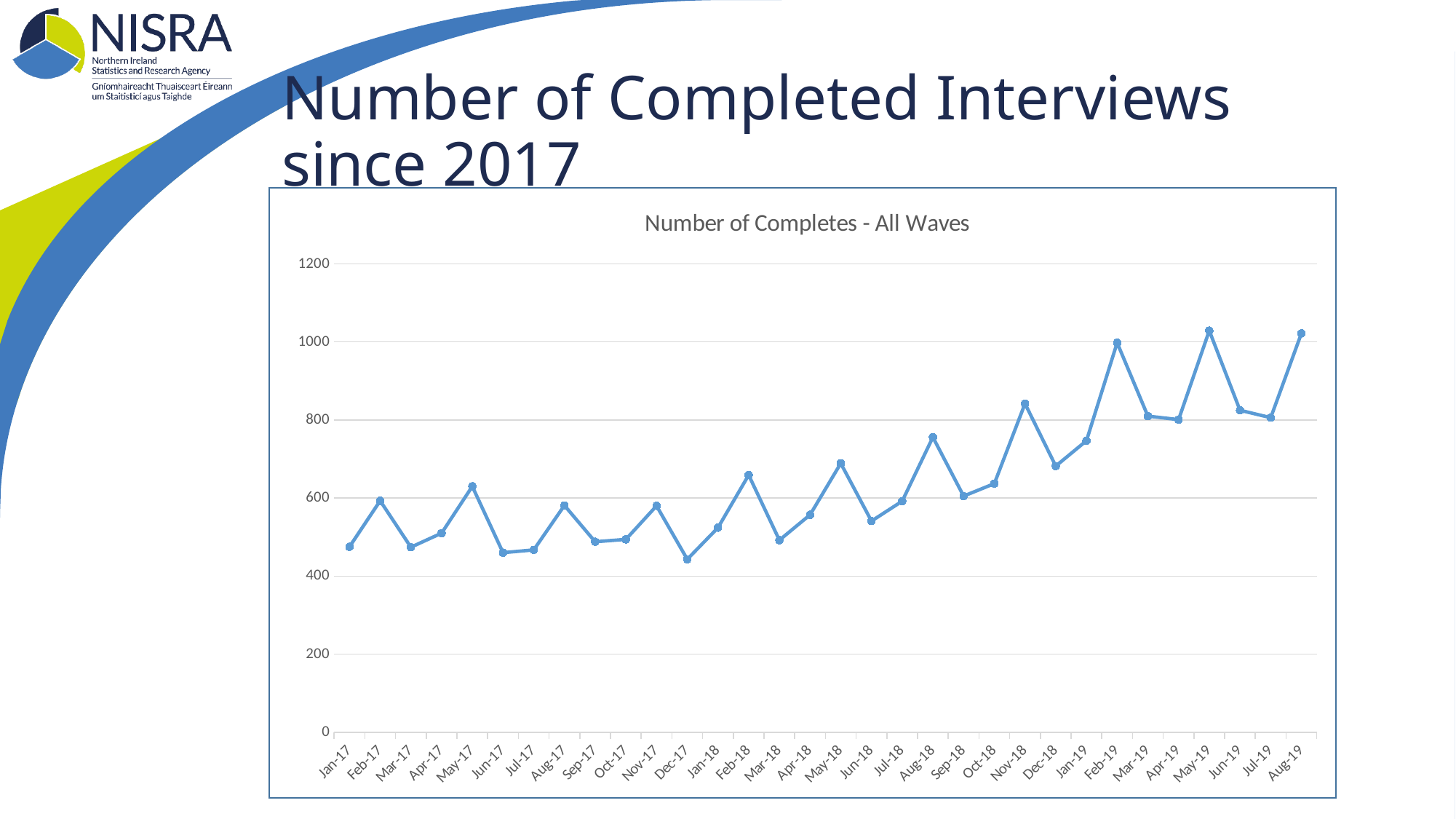
What kind of chart is shown on the slide? line chart Is the value for Nov-18 greater or less than 800? greater Which month has the lowest number of completes? Dec-17 Overall, do the number of completes rise or fall from Jan-17 to Aug-19? rise Is the value for Dec-17 greater or less than 600? less Is the value for May-19 greater or less than 1000? greater Which is larger, the value for Feb-18 or the value for Feb-17? Feb-18 Which is larger, the value for Jan-19 or the value for Jan-18? Jan-19 How many monthly data points are plotted on the chart? 32 What is the title of the chart? Number of Completes - All Waves